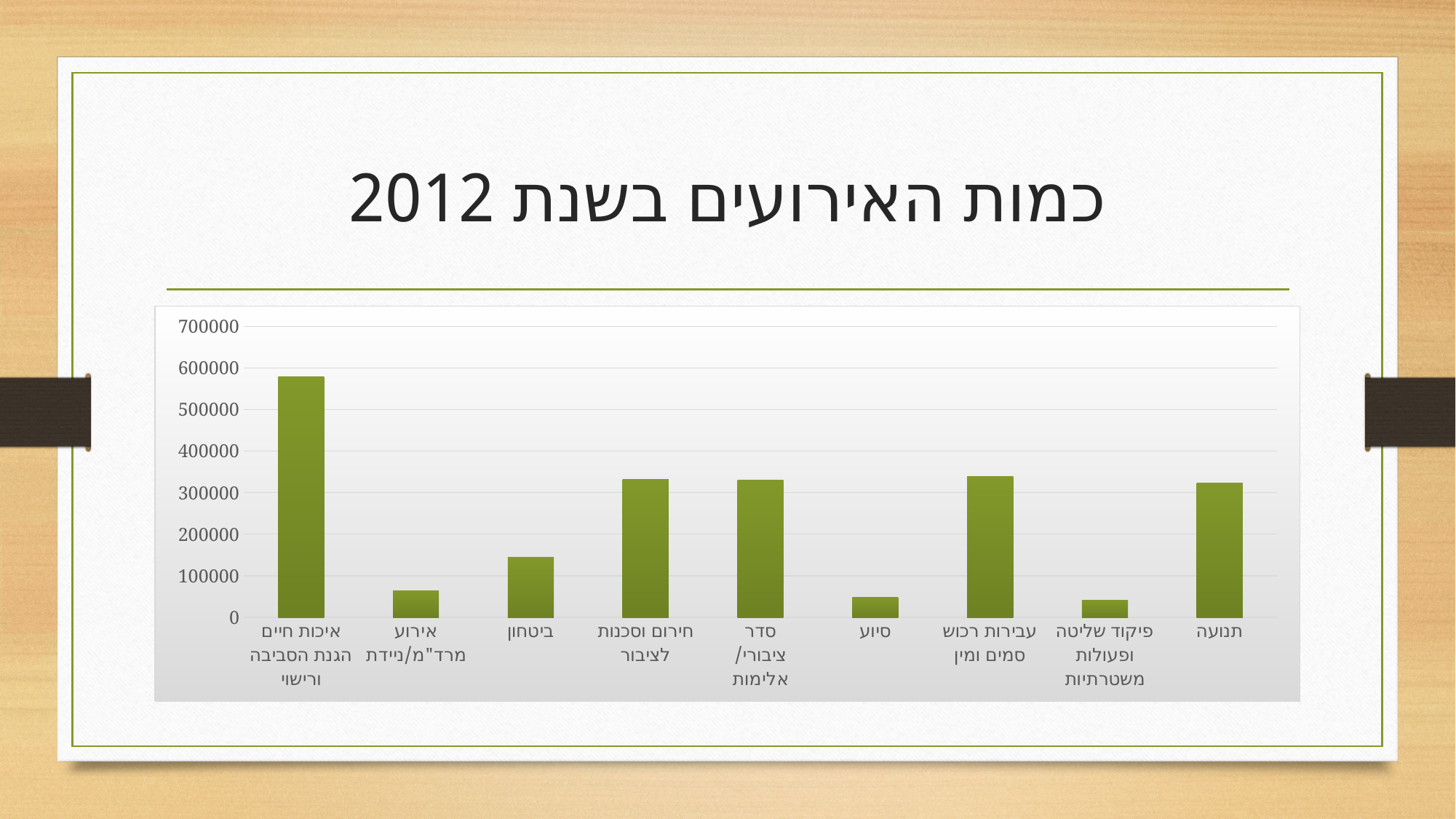
Is the value for ביטחון greater or less than 200000? less Is the value for ביטחון greater or less than 100000? greater Is the value for עבירות רכוש סמים ומין greater or less than 300000? greater What is the title of the chart on the slide? כמות האירועים בשנת 2012 Which is larger, the value for תנועה or the value for פיקוד שליטה ופעולות משטרתיות? תנועה How many categories are shown on the x axis of the chart? 9 Which is larger, the value for ביטחון or the value for אירוע מרד"מ/ניידת? ביטחון Which category has the highest value in the chart? איכות חיים הגנת הסביבה ורישוי What kind of chart is shown on the slide? bar chart